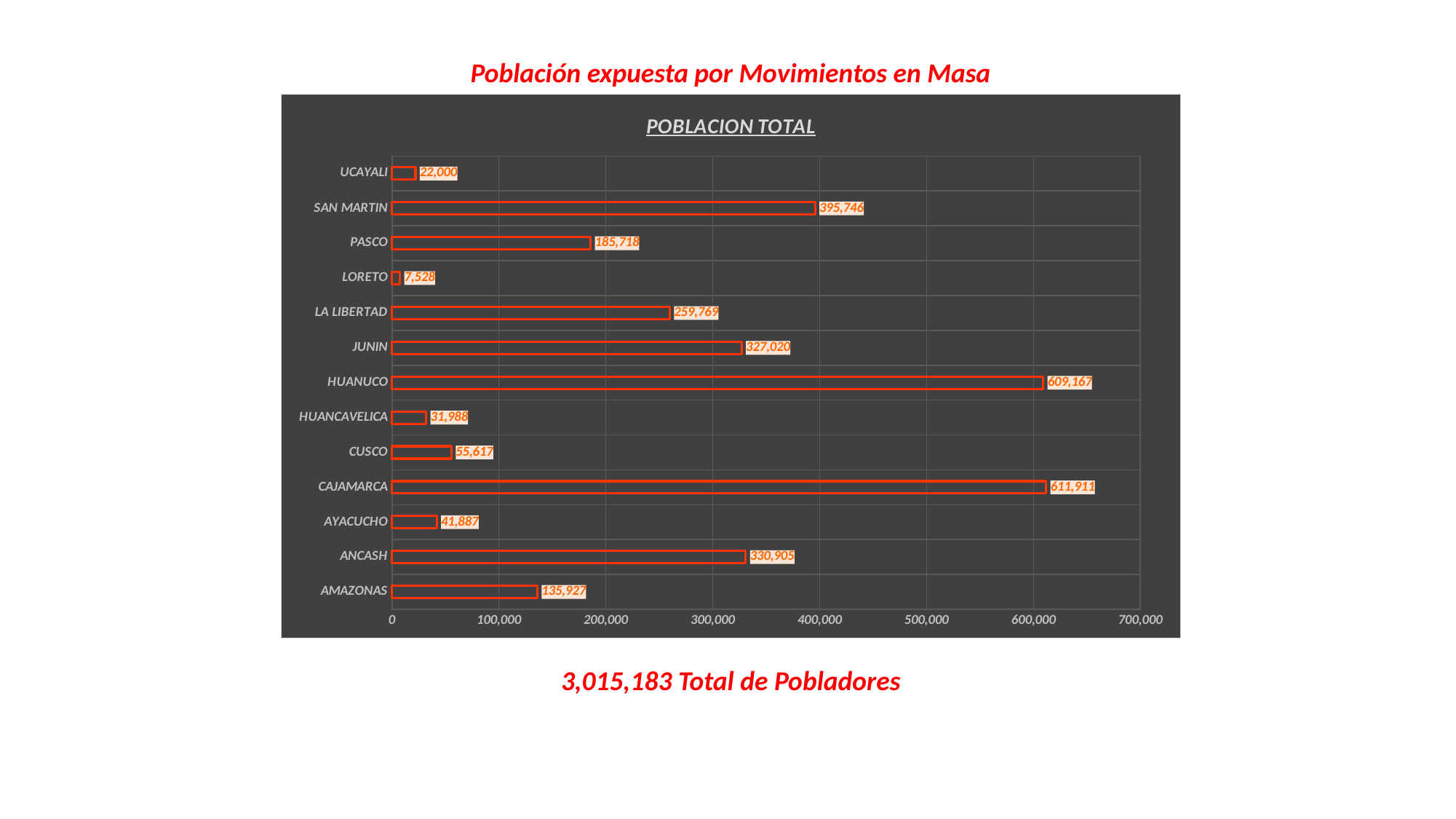
How many regions are shown in the chart? 13 What type of chart is shown on the slide? bar chart What is the population value for AMAZONAS? 135,927 Which region has the lowest population value? LORETO Which has a larger value, JUNIN or LA LIBERTAD? JUNIN What is the difference between the values for CAJAMARCA and HUANUCO? 2,744 Is the value for PASCO greater or less than 200,000? less What is the difference between the values for SAN MARTIN and PASCO? 210,028 Which region has the highest population value? CAJAMARCA What is the population value for HUANCAVELICA? 31,988 What is the title shown inside the chart area? POBLACION TOTAL What is the population value for SAN MARTIN? 395,746